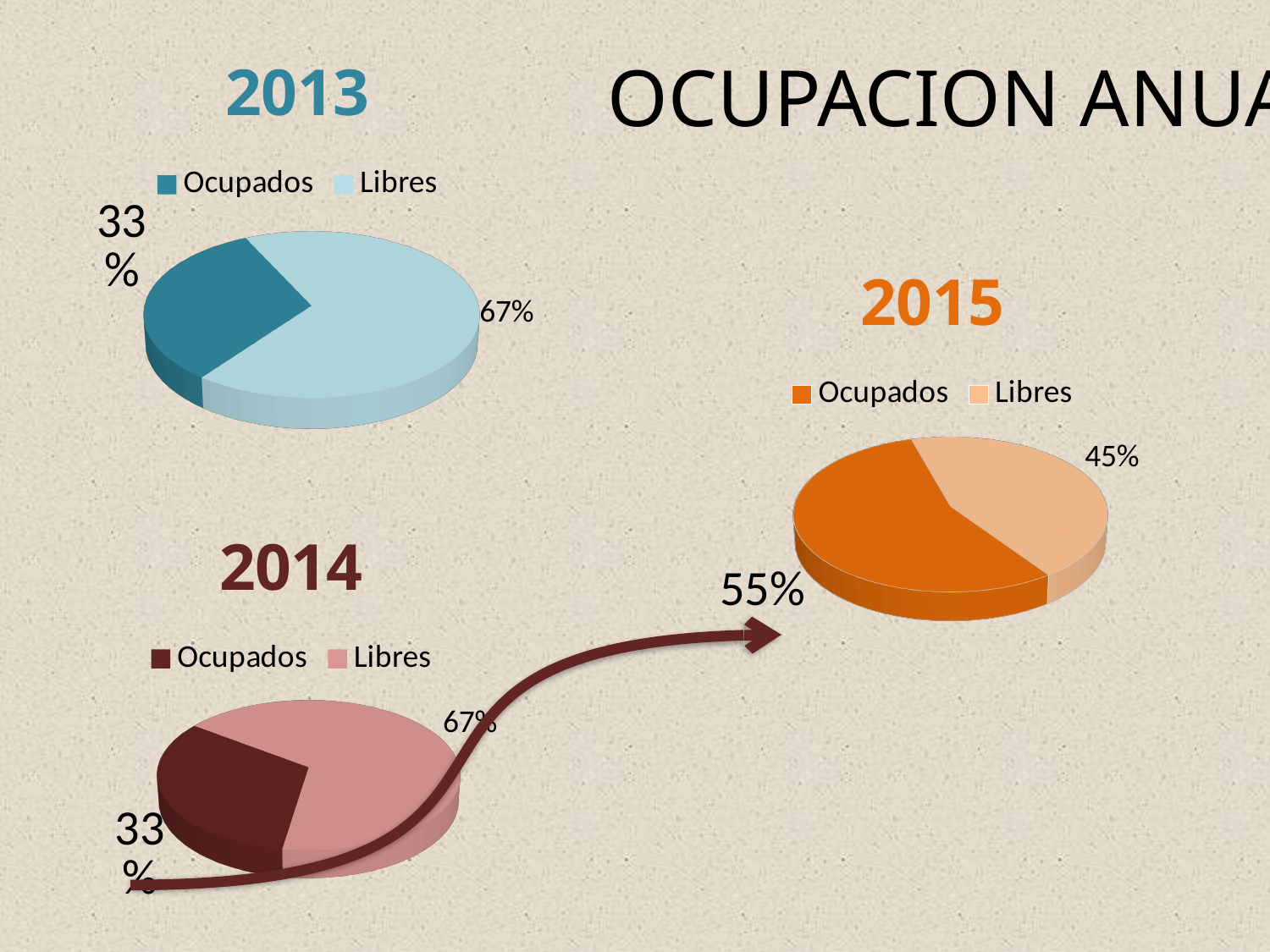
In the 2013 chart, what is the value for Libres? 67% In the 2013 chart, which category has the largest slice? Libres In the 2014 chart, which category has the smallest slice? Ocupados In the 2013 chart, what is the value for Ocupados? 33% How many series does the legend of the 2015 chart list? 2 In the 2015 chart, which slice is larger, Ocupados or Libres? Ocupados In the 2015 chart, what is the value for Ocupados? 55% What kind of chart is the 2014 chart? Pie chart In the 2015 chart, what is the difference between Ocupados and Libres? 10% How many pie charts are shown on the slide? 3 In the 2014 chart, what is the value for Libres? 67% In the 2015 chart, what is the value for Libres? 45%